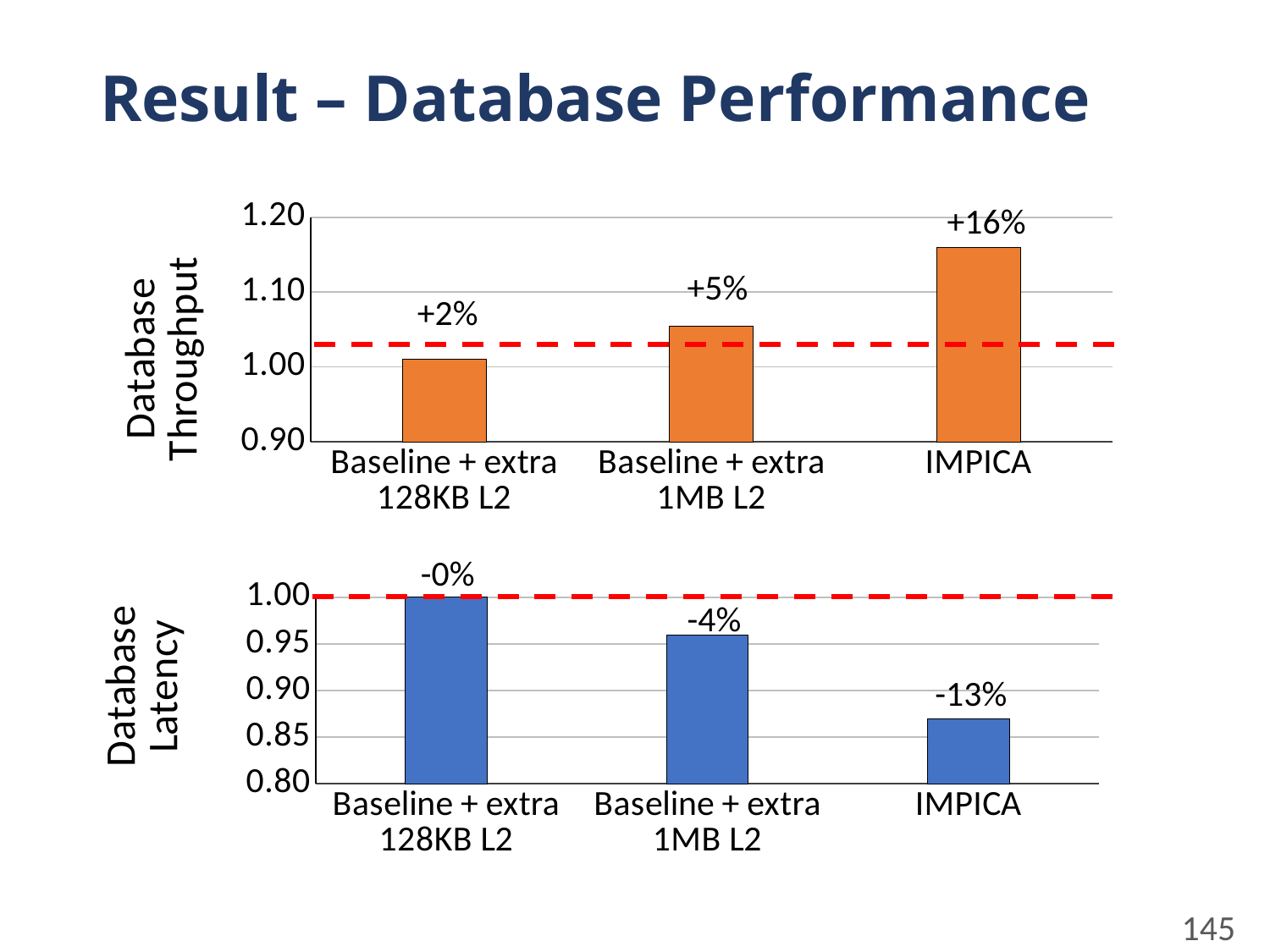
In the Database Latency chart, which category has the lowest bar? IMPICA In the Database Throughput chart, is the value for IMPICA greater or less than 1.10? greater In the Database Latency chart, what label is shown above the Baseline + extra 1MB L2 bar? -4% What type of chart is the Database Throughput chart? bar chart How many categories are shown in the Database Latency chart? 3 In the Database Latency chart, is the value for IMPICA greater or less than 0.90? less What colour are the bars in the Database Latency chart? blue In the Database Throughput chart, what label is shown above the IMPICA bar? +16% In the Database Latency chart, what label is shown above the IMPICA bar? -13% In the Database Throughput chart, which category has the highest bar? IMPICA In the Database Throughput chart, is the bar for Baseline + extra 128KB L2 taller or shorter than the bar for IMPICA? shorter In the Database Throughput chart, what label is shown above the Baseline + extra 1MB L2 bar? +5%